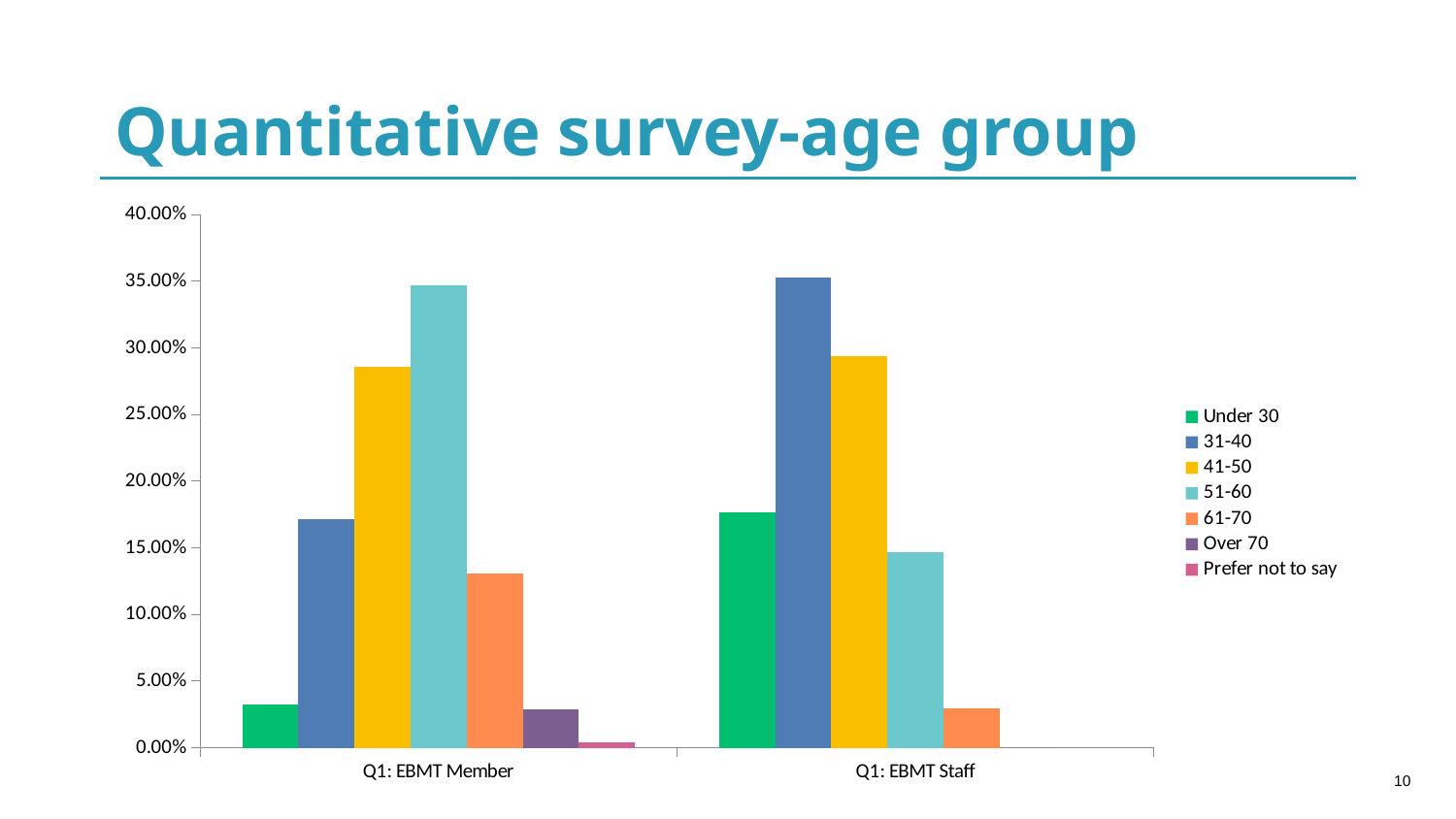
Which age group has the highest value for Q1: EBMT Staff? 31-40 Is the value for 61-70 in Q1: EBMT Member greater or less than 15.00%? less What kind of chart is shown on the slide? Bar chart For Q1: EBMT Staff, which is larger: 41-50 or 51-60? 41-50 Is the value for 51-60 in Q1: EBMT Member greater or less than 30.00%? greater Which age group has the lowest value for Q1: EBMT Member? Prefer not to say Is the value for 31-40 in Q1: EBMT Staff greater or less than 30.00%? greater Which age group has the highest value for Q1: EBMT Member? 51-60 What is the title of the slide? Quantitative survey-age group Which is larger for Under 30: Q1: EBMT Member or Q1: EBMT Staff? Q1: EBMT Staff How many series does the legend list? 7 How many categories are shown on the x axis? 2